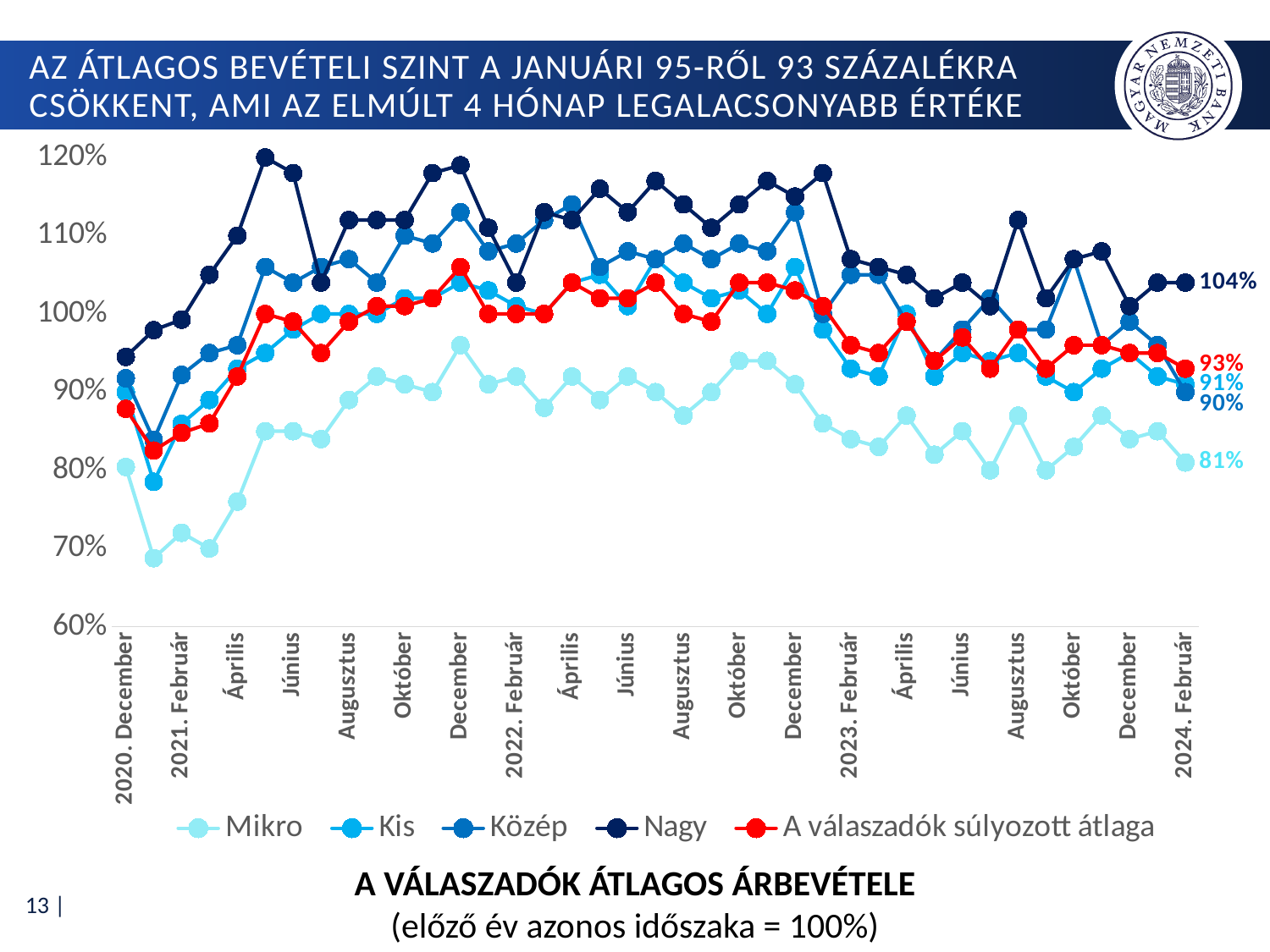
What is the value of 'A válaszadók súlyozott átlaga' at 2024. Február, as labelled at the end of the line? 93% Which series has the lowest value at 2024. Február? Mikro What is the value of the Nagy series at 2024. Február, as labelled at the end of the line? 104% At 2024. Február, which is larger: the Nagy value or the Mikro value? Nagy How many series does the legend list? 5 What is the title printed below the chart? A VÁLASZADÓK ÁTLAGOS ÁRBEVÉTELE (előző év azonos időszaka = 100%) What is the difference between the Nagy value (104%) and the Mikro value (81%) at 2024. Február? 23 percentage points Is the value for Nagy in Június 2021 greater or less than 110%? greater Is the value for Mikro in 2021. Február greater or less than 80%? less What is the value of the Mikro series at 2024. Február, as labelled at the end of the line? 81% Which series has the highest value at 2024. Február? Nagy What kind of chart is shown on the slide? line chart